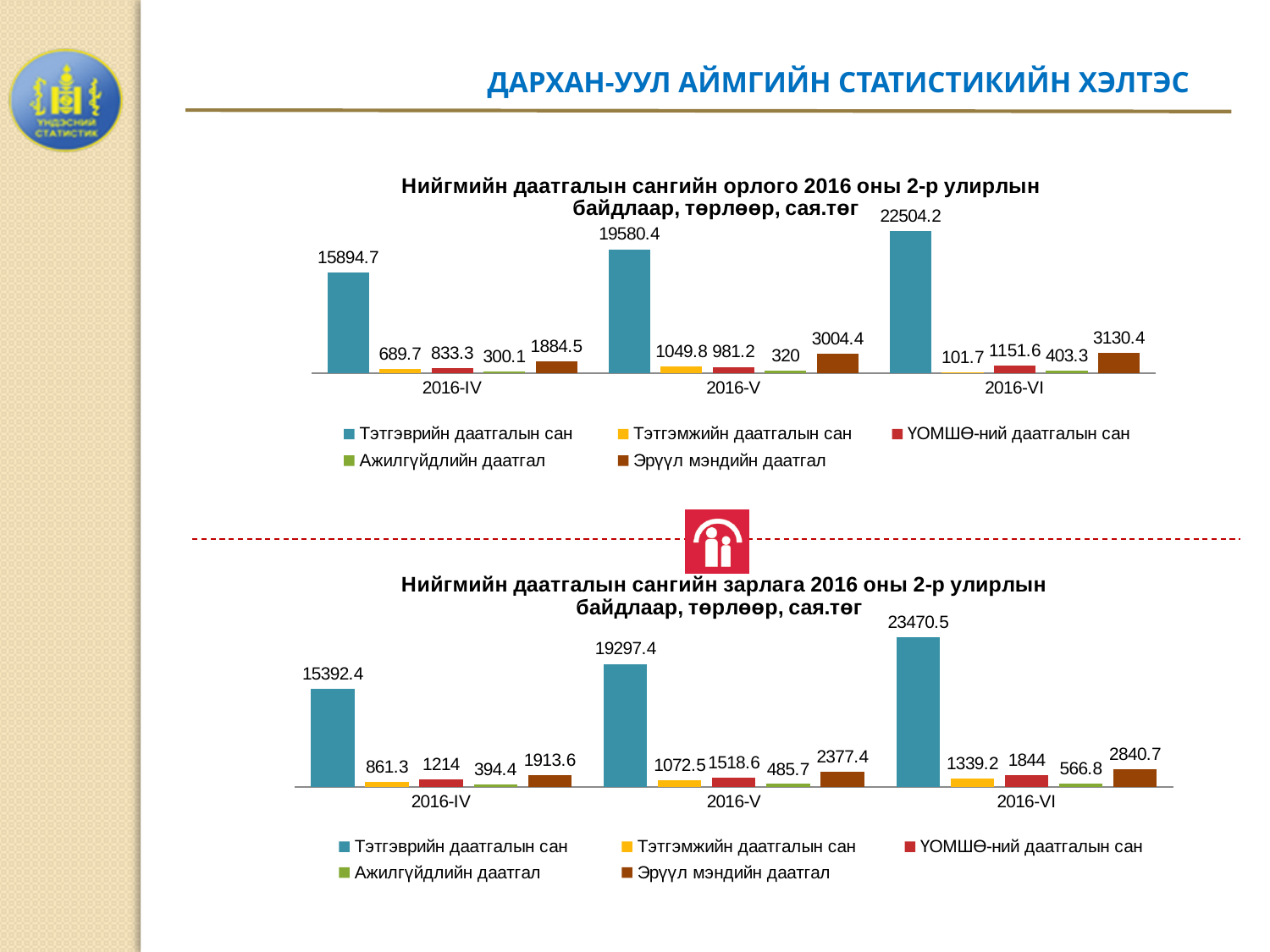
In the top chart (Нийгмийн даатгалын сангийн орлого), what is the difference between the Тэтгэврийн даатгалын сан values for 2016-V and 2016-IV? 3685.7 In the bottom chart (Нийгмийн даатгалын сангийн зарлага), which is larger for 2016-V: Тэтгэмжийн даатгалын сан or ҮОМШӨ-ний даатгалын сан? ҮОМШӨ-ний даатгалын сан In the bottom chart (Нийгмийн даатгалын сангийн зарлага), which quarter has the highest value for Эрүүл мэндийн даатгал? 2016-VI In the top chart (Нийгмийн даатгалын сангийн орлого), what is the value of Тэтгэврийн даатгалын сан for 2016-VI? 22504.2 In the top chart (Нийгмийн даатгалын сангийн орлого), which quarter has the lowest value for Тэтгэмжийн даатгалын сан? 2016-VI In the top chart (Нийгмийн даатгалын сангийн орлого), does the value of Тэтгэврийн даатгалын сан rise or fall from 2016-IV to 2016-VI? rise What type of chart is the bottom chart (Нийгмийн даатгалын сангийн зарлага)? bar chart How many quarters (categories) are shown on the x axis of the bottom chart (Нийгмийн даатгалын сангийн зарлага)? 3 In the bottom chart (Нийгмийн даатгалын сангийн зарлага), what is the value of ҮОМШӨ-ний даатгалын сан for 2016-VI? 1844 In the top chart (Нийгмийн даатгалын сангийн орлого), what is the value of Эрүүл мэндийн даатгал for 2016-V? 3004.4 How many series does the legend of the top chart (Нийгмийн даатгалын сангийн орлого) list? 5 In the bottom chart (Нийгмийн даатгалын сангийн зарлага), what is the value of Ажилгүйдлийн даатгал for 2016-IV? 394.4